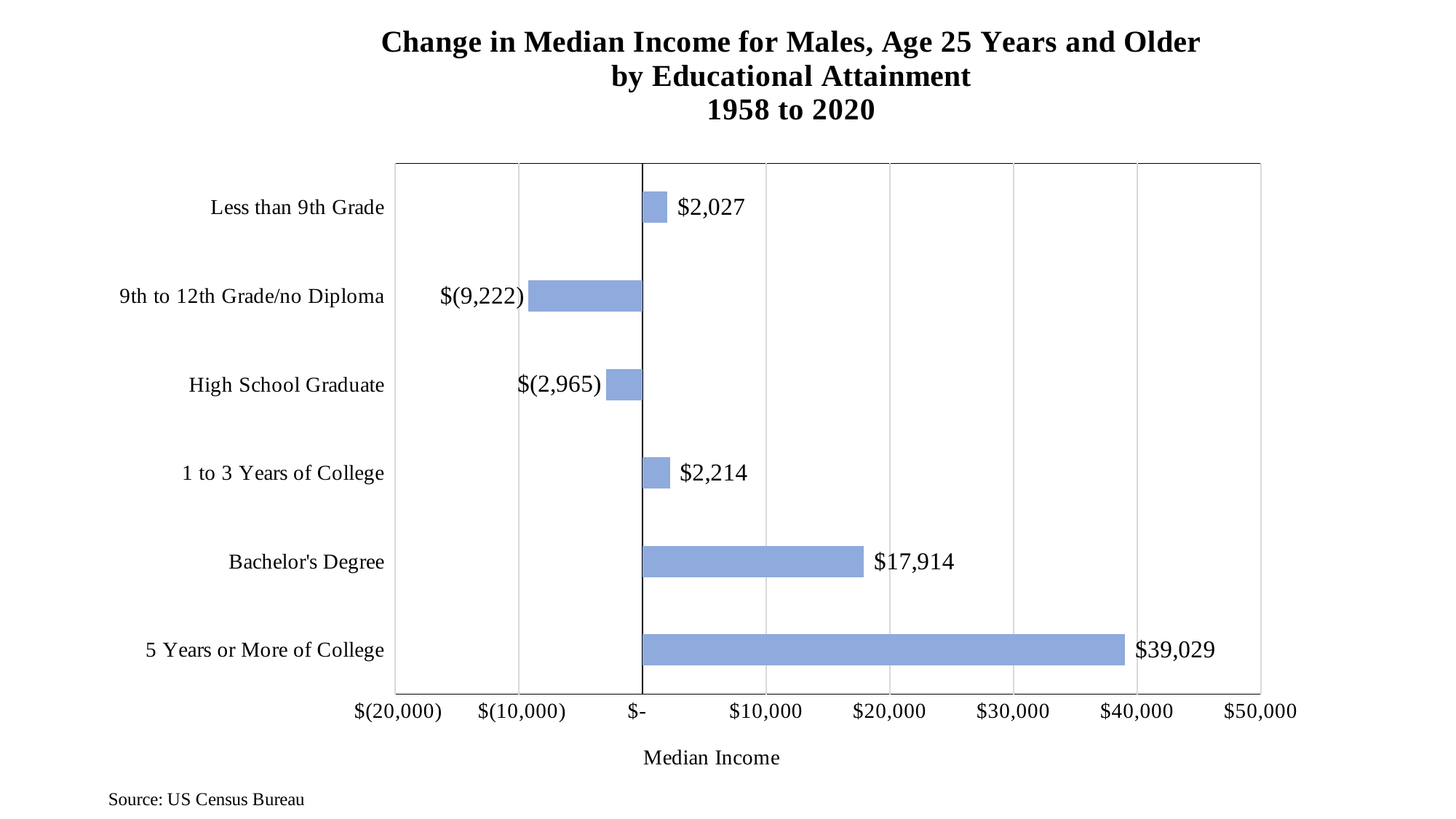
Is the value for 5 Years or More of College greater or less than $30,000? greater What kind of chart is shown on the slide? Bar chart Which has a larger change in median income: 1 to 3 Years of College or Less than 9th Grade? 1 to 3 Years of College What is the change in median income for High School Graduate males? $(2,965) What is the source cited for the chart data? US Census Bureau Which educational attainment category has the lowest change in median income? 9th to 12th Grade/no Diploma How many educational attainment categories are shown in the chart? 6 What is the change in median income for males with a Bachelor's Degree? $17,914 What is the change in median income for males with 9th to 12th Grade/no Diploma? $(9,222) What is the difference between the change in median income for 5 Years or More of College and Bachelor's Degree? $21,115 What is the change in median income for males with Less than 9th Grade education? $2,027 Which educational attainment category has the highest change in median income? 5 Years or More of College